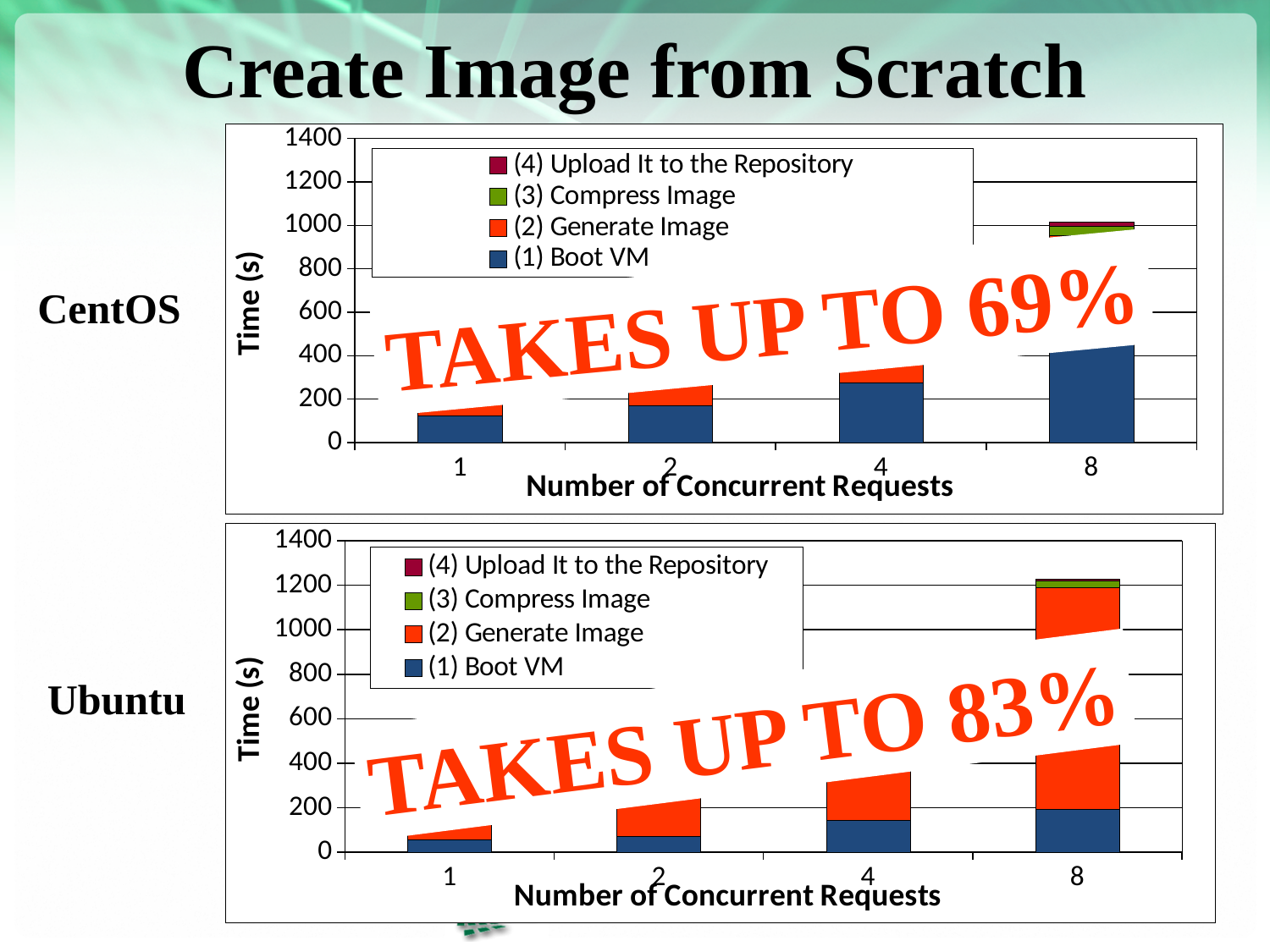
In the Ubuntu chart, how many categories are shown on the x axis? 4 In the Ubuntu chart, which number of concurrent requests has the tallest total bar? 8 In the Ubuntu chart, what is the label of the x axis? Number of Concurrent Requests In the CentOS chart, which number of concurrent requests has the shortest total bar? 1 In the CentOS chart, is the (1) Boot VM time for 8 concurrent requests greater or less than 400? greater In the CentOS chart, what is the label of the y axis? Time (s) In the Ubuntu chart, which has the larger total time: 4 or 8 concurrent requests? 8 In the CentOS chart, what kind of chart is shown? stacked bar chart In the CentOS chart, how many series does the legend list? 4 In the Ubuntu chart, do the total bar heights rise or fall as the number of concurrent requests increases? rise